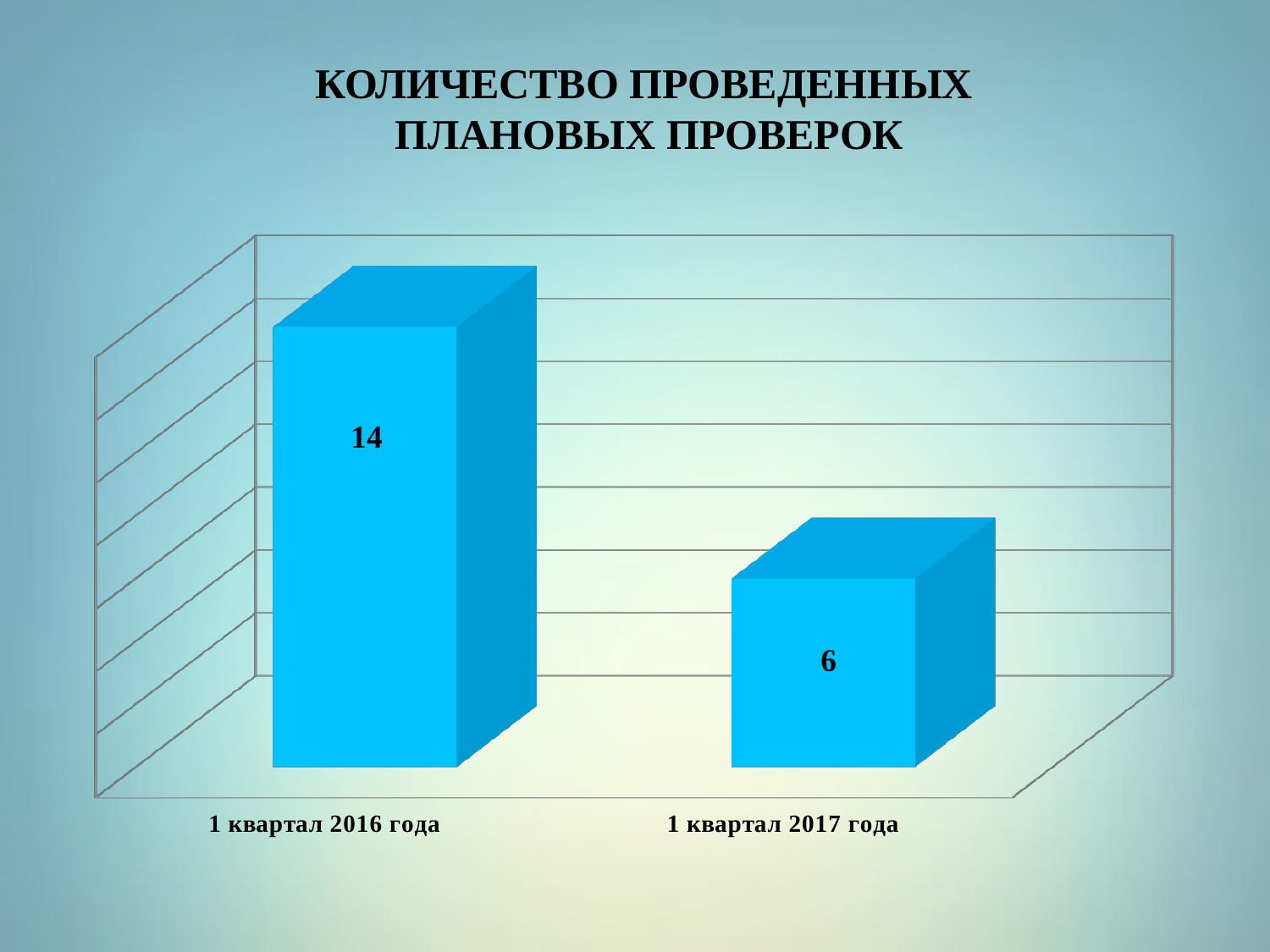
Do the values rise or fall from 1 квартал 2016 года to 1 квартал 2017 года? fall What is the difference between the values for 1 квартал 2016 года and 1 квартал 2017 года? 8 Which is larger, the value for 1 квартал 2016 года or for 1 квартал 2017 года? 1 квартал 2016 года What is the title of the chart? КОЛИЧЕСТВО ПРОВЕДЕННЫХ ПЛАНОВЫХ ПРОВЕРОК What colour are the bars in the chart? blue How many categories are shown in the chart? 2 Which category has the lowest value? 1 квартал 2017 года Which category has the highest value? 1 квартал 2016 года What is the value for 1 квартал 2017 года? 6 What is the value for 1 квартал 2016 года? 14 What kind of chart is shown on the slide? bar chart